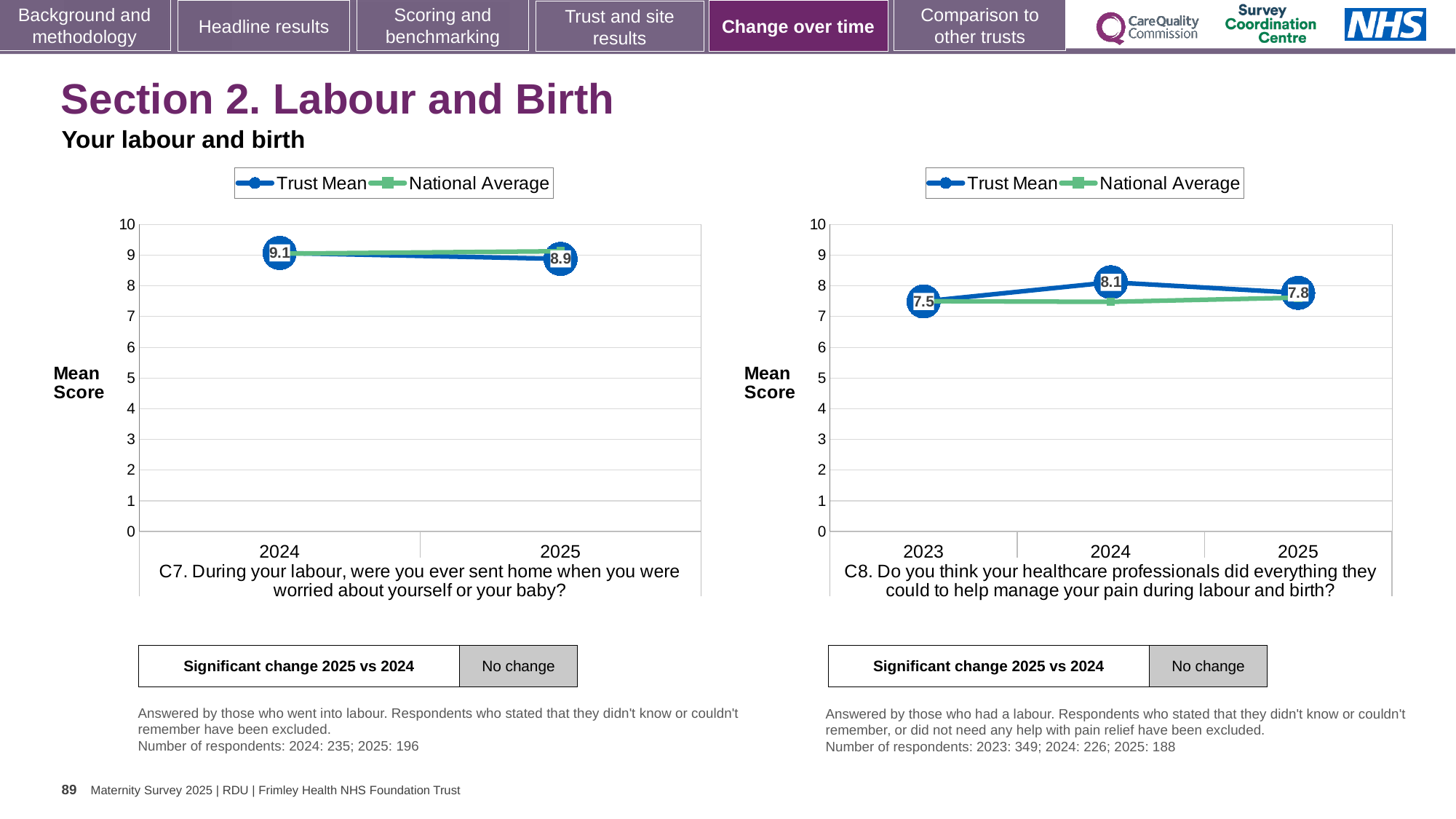
In the left chart (C7), what is the Trust Mean score for 2024? 9.1 In the left chart (C7), is the Trust Mean for 2024 or 2025 higher? 2024 In the right chart (C8), which year has the lowest Trust Mean score? 2023 In the right chart (C8), is the National Average value for 2024 greater or less than 8? less In the right chart (C8), what is the difference between the Trust Mean scores for 2024 and 2023? 0.6 In the right chart (C8), which year has the highest Trust Mean score? 2024 In the right chart (C8), what is the Trust Mean score for 2024? 8.1 In the right chart (C8), what is the Trust Mean score for 2023? 7.5 In the left chart (C7), what is the difference between the Trust Mean scores for 2024 and 2025? 0.2 How many years are plotted on the x axis of the right chart (C8)? 3 In the left chart (C7), what is the Trust Mean score for 2025? 8.9 How many series does the legend of the left chart (C7) list? 2